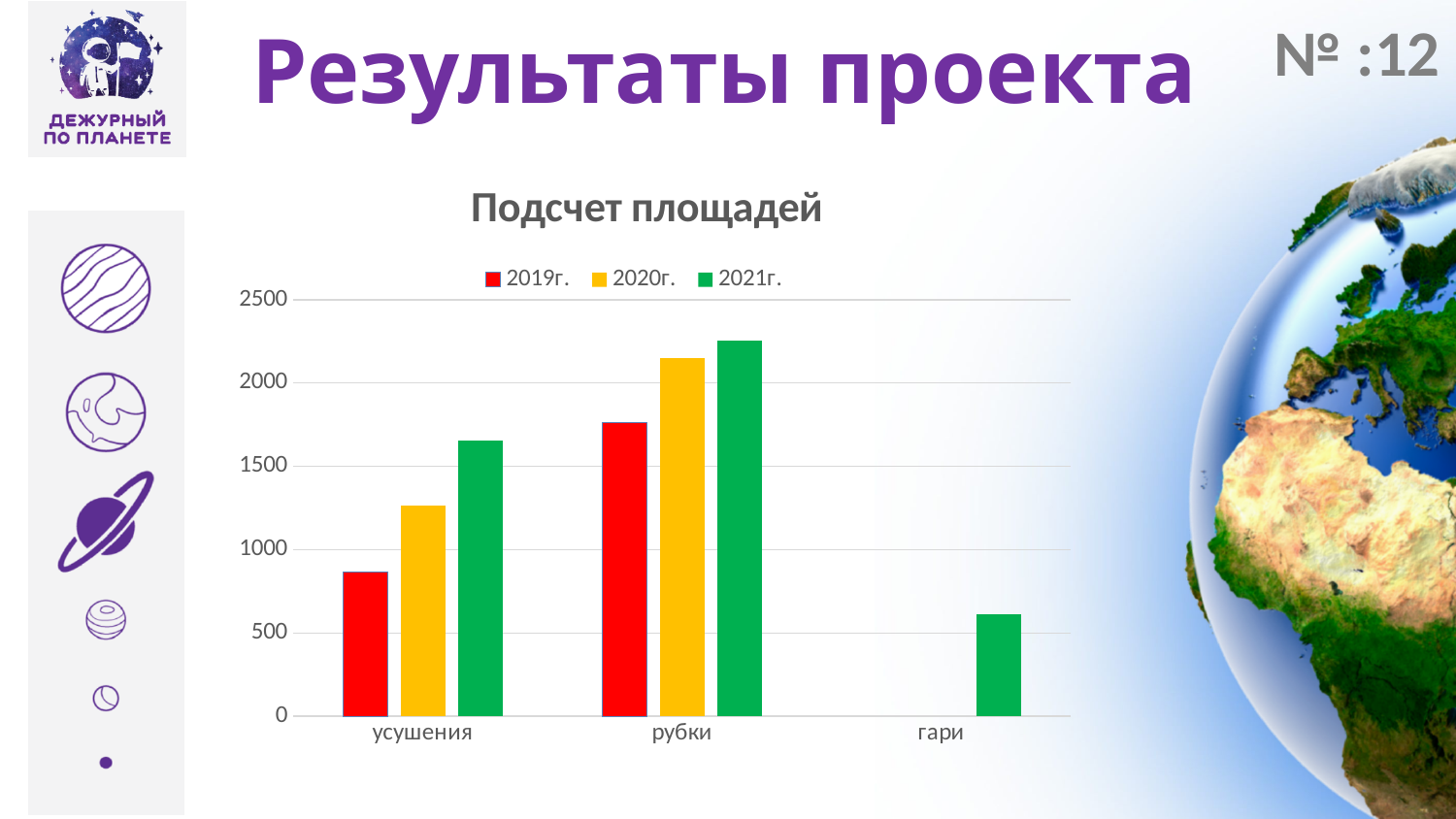
What is the title of the chart? Подсчет площадей Which colour represents the 2021г. series? green Which is larger for усушения: the 2019г. value or the 2020г. value? 2020г. For the category усушения, do the values rise or fall from 2019г. to 2021г.? rise Is the value for усушения in 2019г. greater or less than 1000? less Is the value for рубки in 2020г. greater or less than 2000? greater Which category has the highest bar in the chart? рубки Is the value for усушения in 2021г. greater or less than 1500? greater How many series does the legend list? 3 What kind of chart is shown on the slide? bar chart How many categories are shown on the x axis? 3